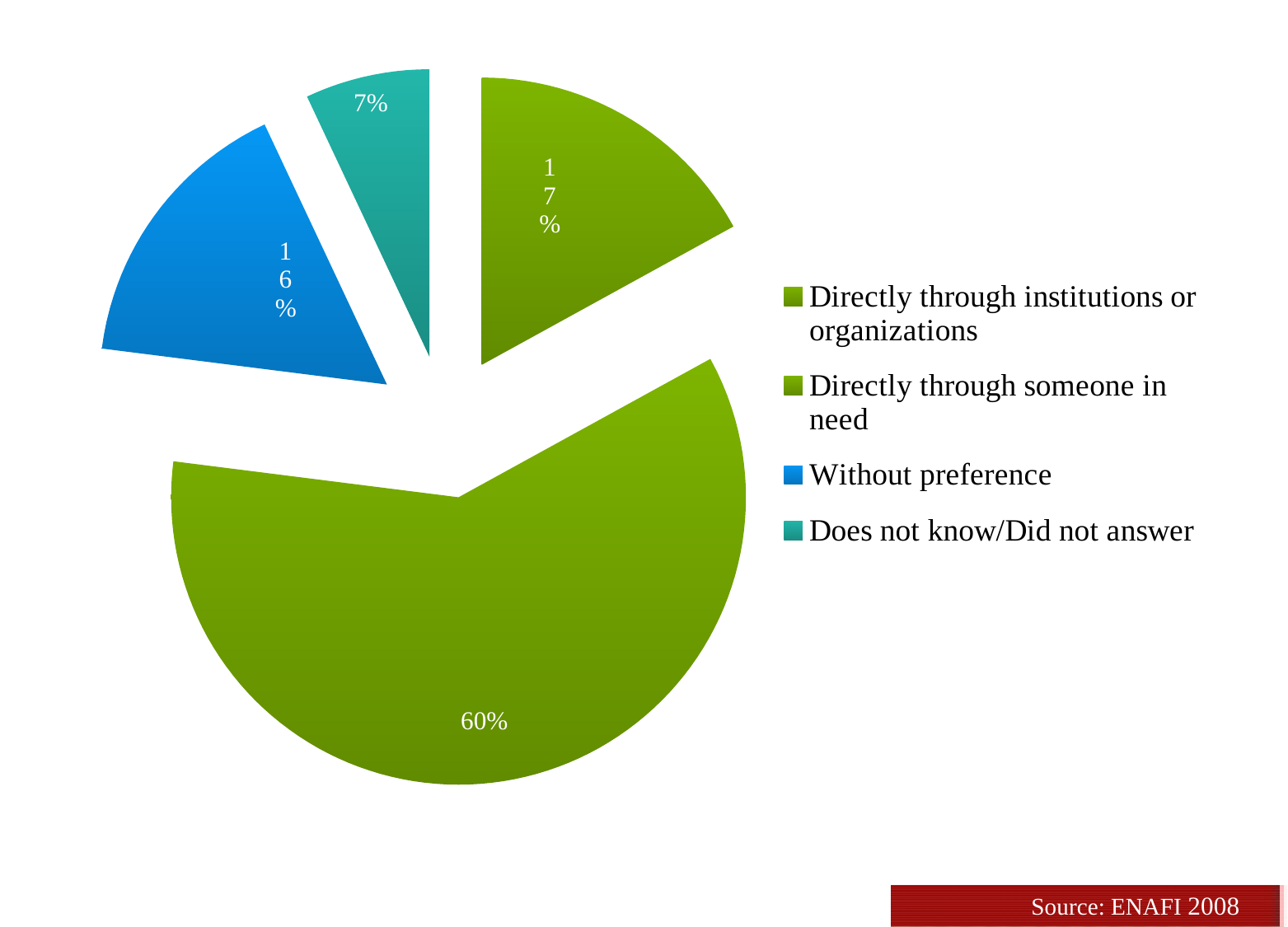
Which category has the largest slice of the pie? Directly through someone in need Which is larger, the slice for 'Without preference' or the slice for 'Does not know/Did not answer'? Without preference How many slices does the pie chart have? 4 What share of the pie is labelled 'Directly through someone in need'? 60% What source is cited on the slide? ENAFI 2008 What share of the pie is labelled 'Directly through institutions or organizations'? 17% What share of the pie is labelled 'Does not know/Did not answer'? 7% What kind of chart is shown on the slide? Pie chart What is the difference in percentage points between 'Directly through someone in need' and 'Directly through institutions or organizations'? 43 Which category has the smallest slice of the pie? Does not know/Did not answer What share of the pie is labelled 'Without preference'? 16% What colour is the slice for 'Without preference'? Blue